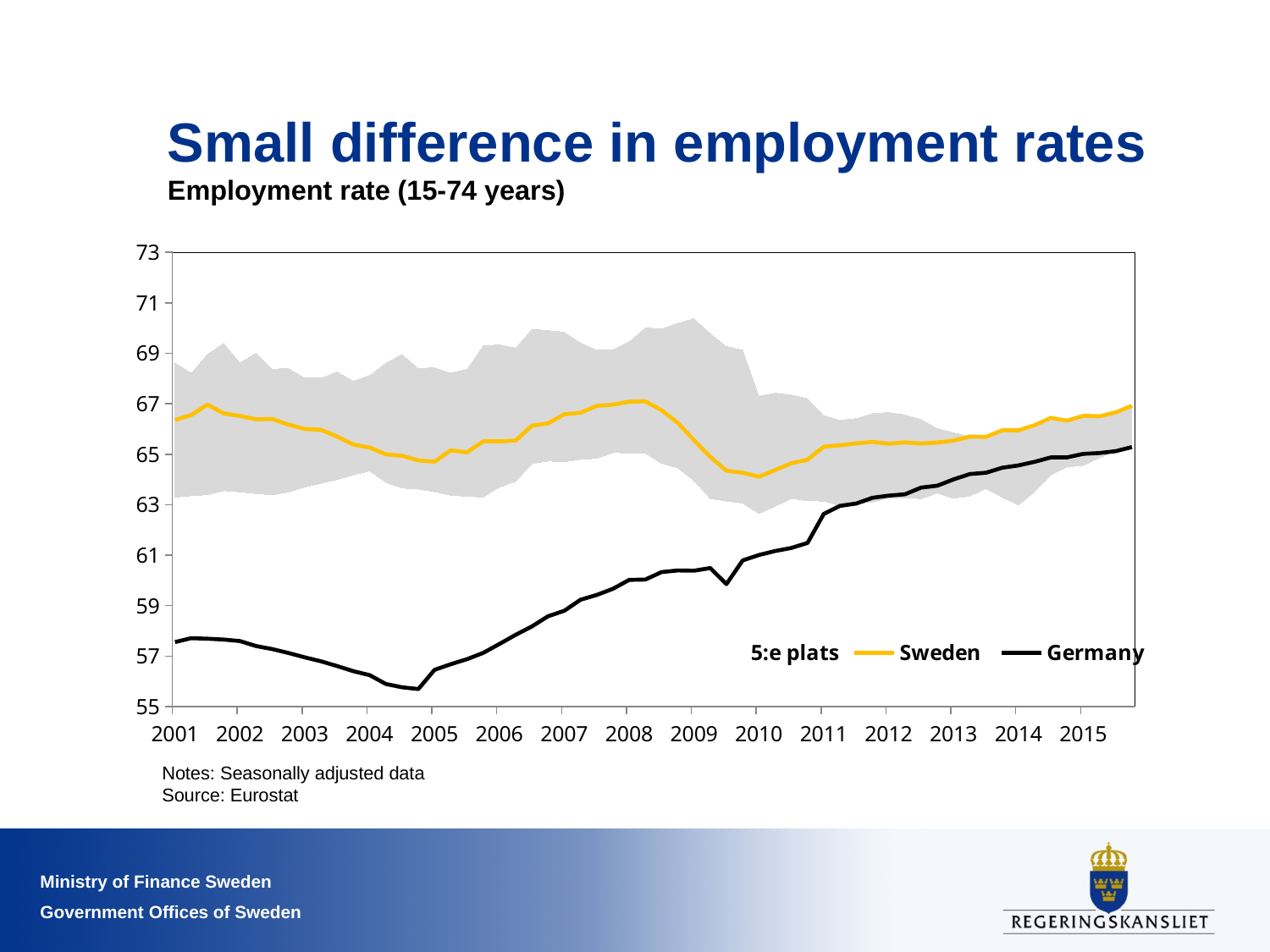
Is the value for Sweden in 2008 greater or less than 65? greater Does the Germany line rise or fall between 2005 and 2015? Rise Is the value for Germany in 2015 greater or less than 63? greater Is the value for Sweden in 2010 greater or less than 65? less How many year labels are shown on the x axis? 15 What is the subtitle describing the measure plotted in the chart? Employment rate (15-74 years) What kind of chart is shown on the slide? Line chart Does the Sweden line rise or fall between 2008 and 2010? Fall Which two countries are plotted as lines in the chart? Sweden and Germany How many entries does the chart legend list? 3 In 2005, which line is higher, Sweden or Germany? Sweden